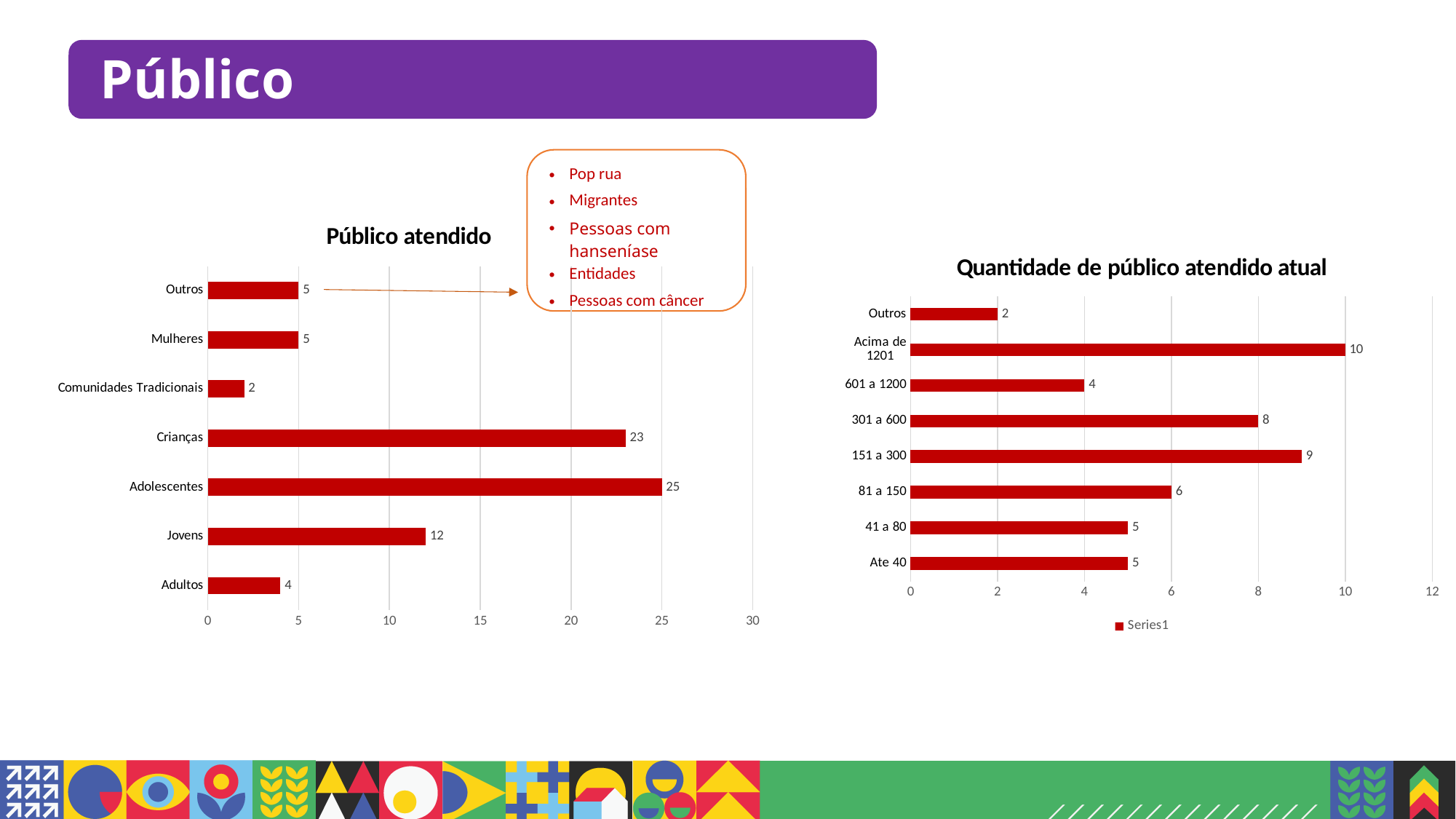
What type of chart is 'Quantidade de público atendido atual'? Bar chart In the 'Quantidade de público atendido atual' chart, which category has the highest value? Acima de 1201 In the 'Público atendido' chart, which category has the lowest value? Comunidades Tradicionais In the 'Quantidade de público atendido atual' chart, what is the difference between 151 a 300 and 81 a 150? 3 In the 'Público atendido' chart, what is the value for Adolescentes? 25 In the 'Quantidade de público atendido atual' chart, how many series does the legend list? 1 In the 'Público atendido' chart, how many categories are shown? 7 In the 'Público atendido' chart, what is the difference between Adolescentes and Crianças? 2 In the 'Quantidade de público atendido atual' chart, which category has the lowest value? Outros In the 'Público atendido' chart, which is larger, Jovens or Adultos? Jovens In the 'Quantidade de público atendido atual' chart, what is the value for 301 a 600? 8 In the 'Público atendido' chart, what is the value for Jovens? 12